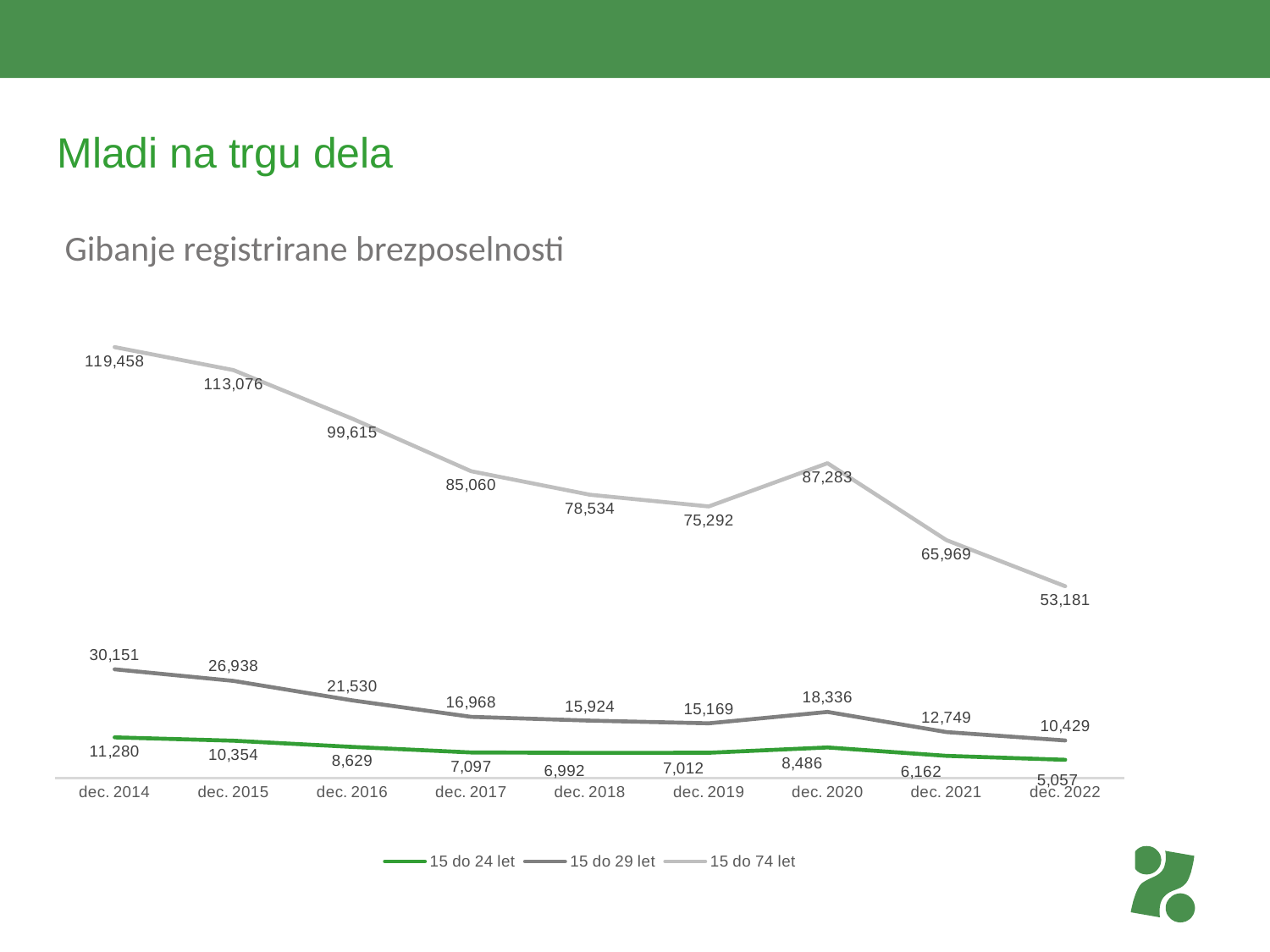
What is the value for the 15 do 24 let series in dec. 2022? 5,057 What type of chart is shown on the slide? line chart What is the overall trend of the 15 do 29 let series from dec. 2014 to dec. 2022? falling In which year is the 15 do 74 let series at its lowest? dec. 2022 In which year is the 15 do 24 let series at its highest? dec. 2014 What is the subtitle of the chart? Gibanje registrirane brezposelnosti Which is larger: the 15 do 29 let value in dec. 2017 or in dec. 2018? dec. 2017 What is the value for the 15 do 74 let series in dec. 2014? 119,458 What is the value for the 15 do 29 let series in dec. 2020? 18,336 How many series does the legend list? 3 What is the difference between the 15 do 74 let values in dec. 2019 and dec. 2020? 11,991 How many time points are plotted along the x axis? 9